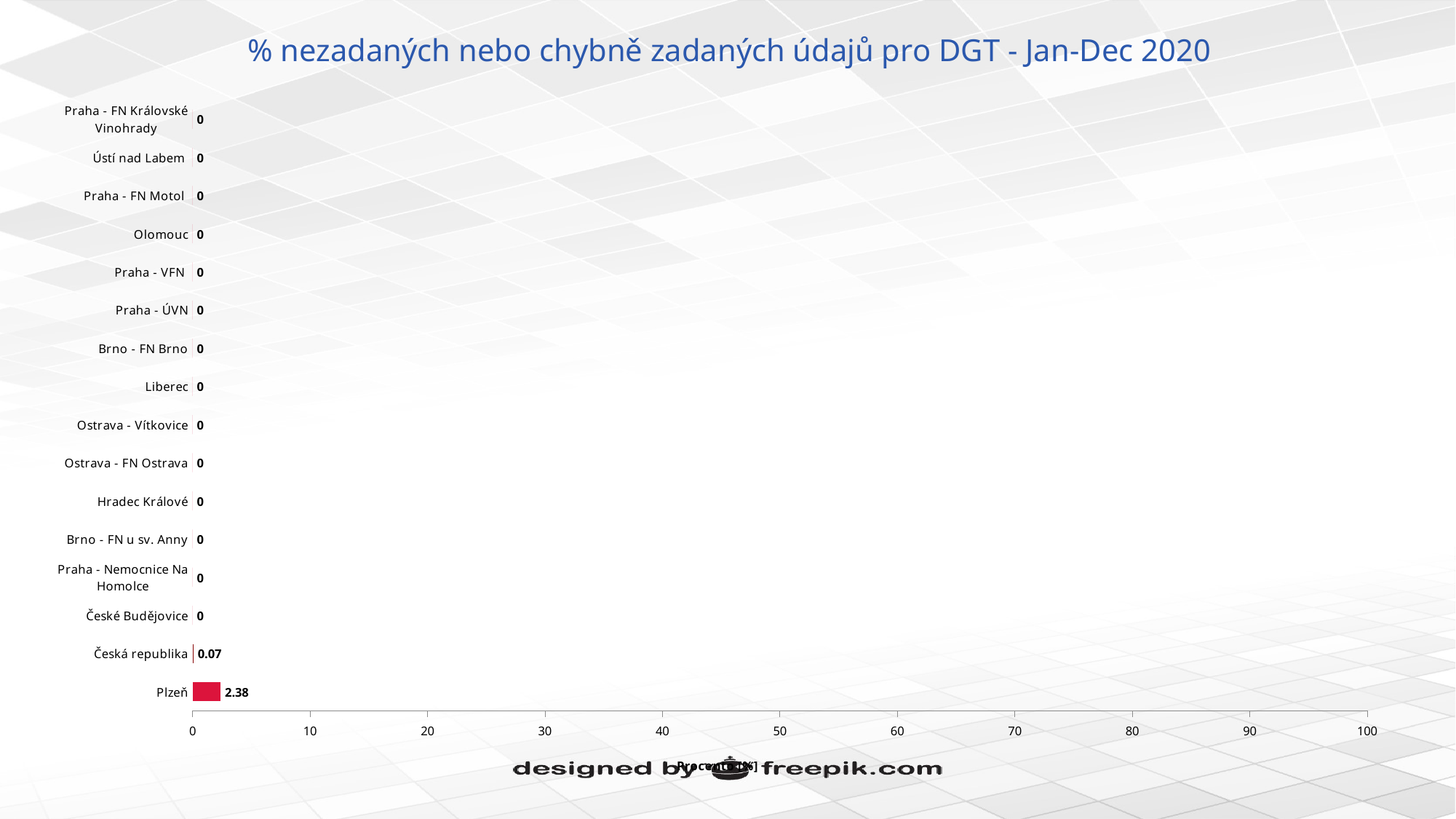
What is the title of the chart? % nezadaných nebo chybně zadaných údajů pro DGT - Jan-Dec 2020 Is the value for Plzeň greater or less than 10? less Which category has the highest value? Plzeň What is the value for Hradec Králové? 0 What is the difference between the values for Plzeň and Česká republika? 2.31 What is the value for Česká republika? 0.07 What is the value for Plzeň? 2.38 Which has a larger value, Plzeň or Liberec? Plzeň What is the maximum value shown on the x axis? 100 How many categories are shown on the chart? 16 What is the value for Olomouc? 0 What type of chart is shown on the slide? bar chart